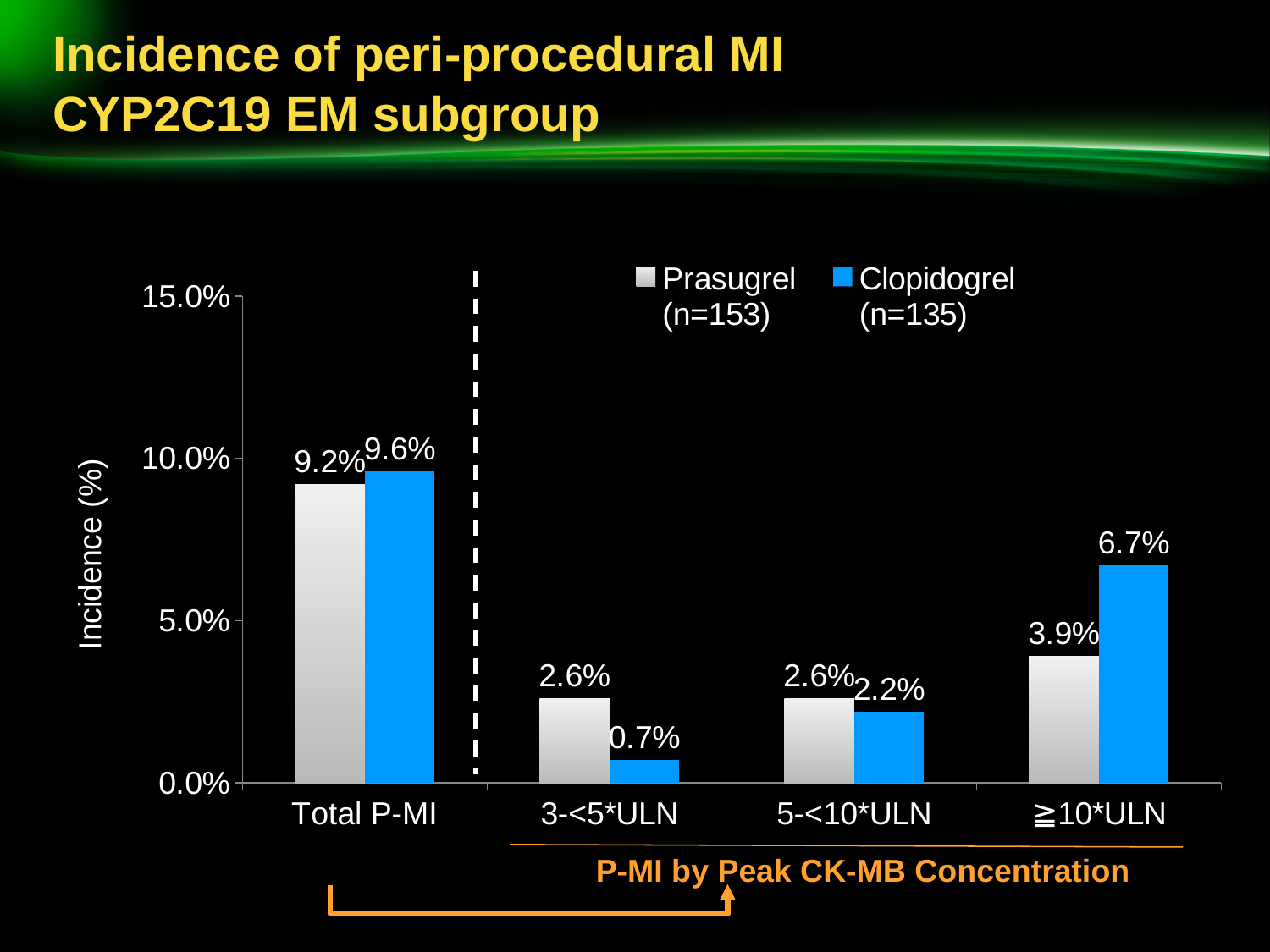
For 3-<5*ULN, which series has the larger value, Prasugrel or Clopidogrel? Prasugrel What is the Clopidogrel value for 5-<10*ULN? 2.2% Which category has the lowest Clopidogrel value? 3-<5*ULN What is the Clopidogrel value for Total P-MI? 9.6% How many categories are shown on the x axis? 4 What is the Prasugrel value for Total P-MI? 9.2% What is the Clopidogrel value for 3-<5*ULN? 0.7% What kind of chart is shown on the slide? Bar chart What is the difference between the Clopidogrel and Prasugrel values for ≧10*ULN? 2.8% Which category has the highest Clopidogrel value? Total P-MI How many series does the legend list? 2 What is the Prasugrel value for ≧10*ULN? 3.9%